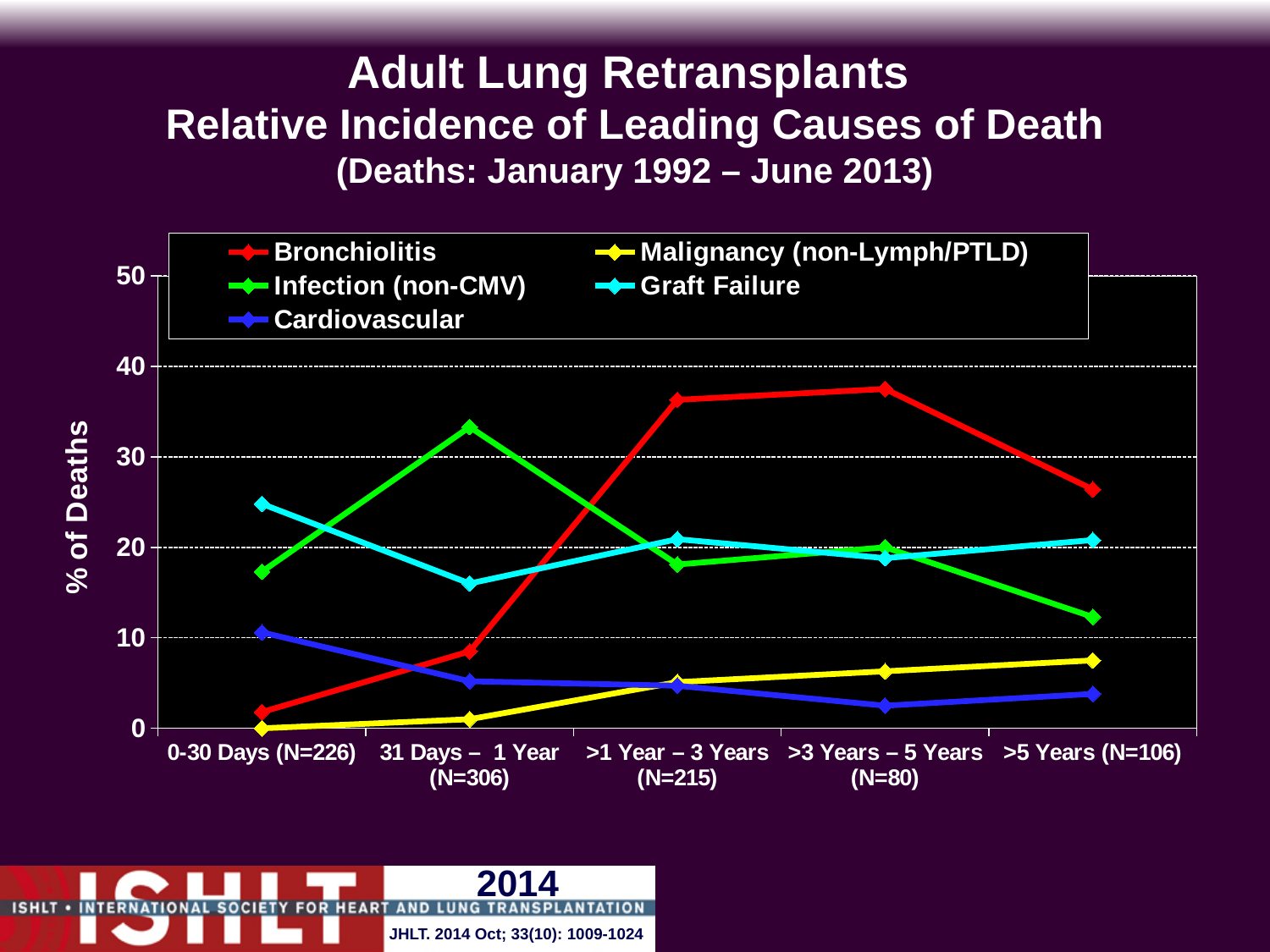
Which cause of death has the highest % of deaths in the >3 Years – 5 Years period? Bronchiolitis Which cause of death has the lowest % of deaths in the 0-30 Days period? Malignancy (non-Lymph/PTLD) Is the value for Bronchiolitis in the >1 Year – 3 Years period greater or less than 30? greater How many series does the legend list? 5 How many time-period categories are shown on the x axis? 5 Does the Malignancy (non-Lymph/PTLD) line rise or fall from 0-30 Days to >5 Years? rises What is the label on the y axis? % of Deaths What kind of chart is shown on the slide? line chart Which cause of death has the highest % of deaths in the 0-30 Days period? Graft Failure In the 31 Days – 1 Year period, which is larger: Infection (non-CMV) or Graft Failure? Infection (non-CMV) Is the value for Cardiovascular in the 0-30 Days period greater or less than 20? less Is the value for Infection (non-CMV) in the 31 Days – 1 Year period greater or less than 30? greater